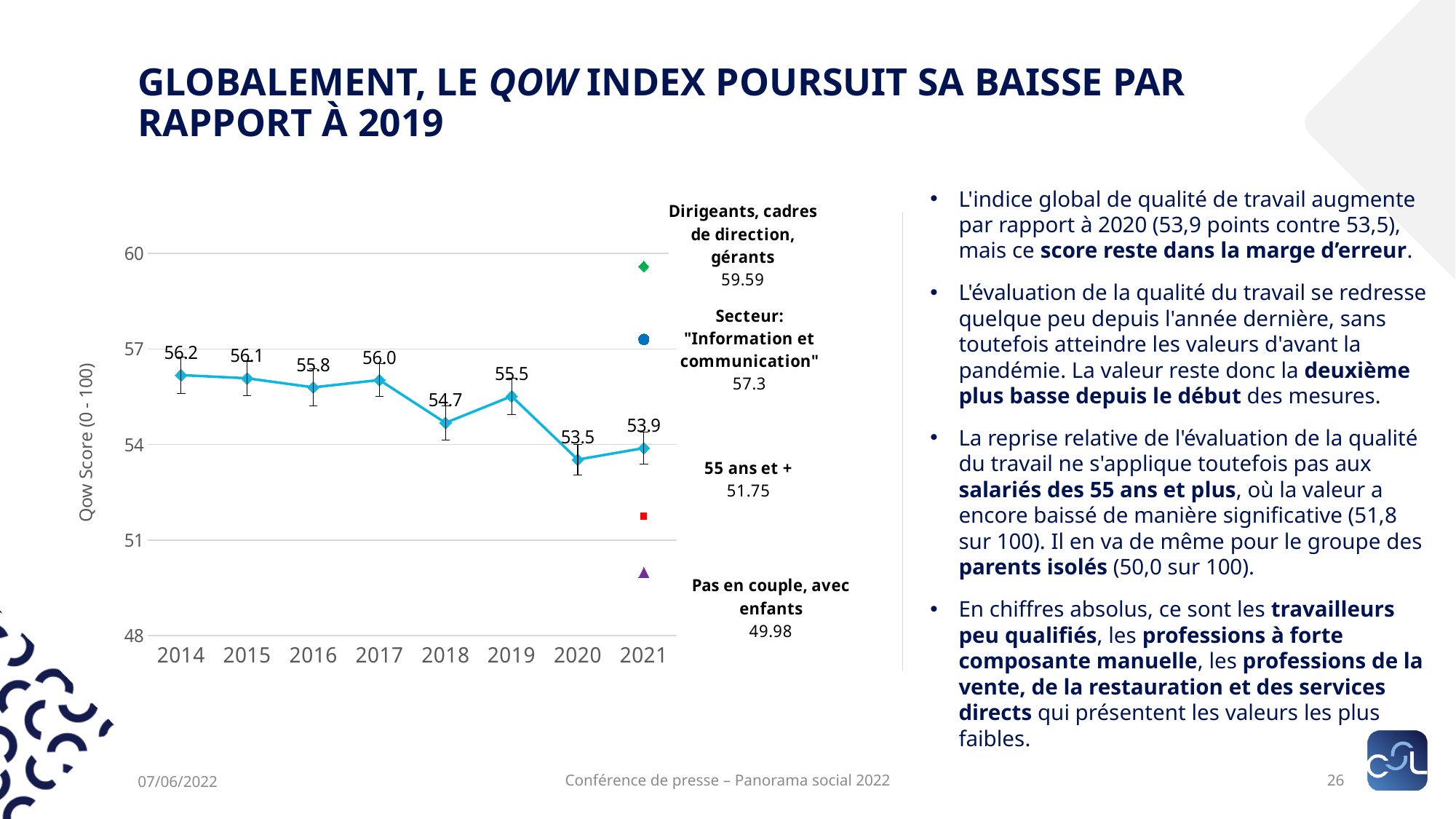
Does the QoW Score generally rise or fall from 2014 to 2021? fall What is the QoW Score for 2018? 54.7 How many years are plotted on the x axis of the line chart? 8 What is the QoW Score for 2014? 56.2 What is the QoW Score for 2021? 53.9 What is the difference between the QoW Score in 2019 and in 2020? 2.0 What kind of chart shows the QoW Score from 2014 to 2021? line chart Which year has the highest QoW Score on the line? 2014 What is the 2021 value shown for 'Dirigeants, cadres de direction, gérants'? 59.59 Which year has the lowest QoW Score on the line? 2020 Is the QoW Score higher in 2017 or in 2018? 2017 What is the 2021 value shown for 'Pas en couple, avec enfants'? 49.98